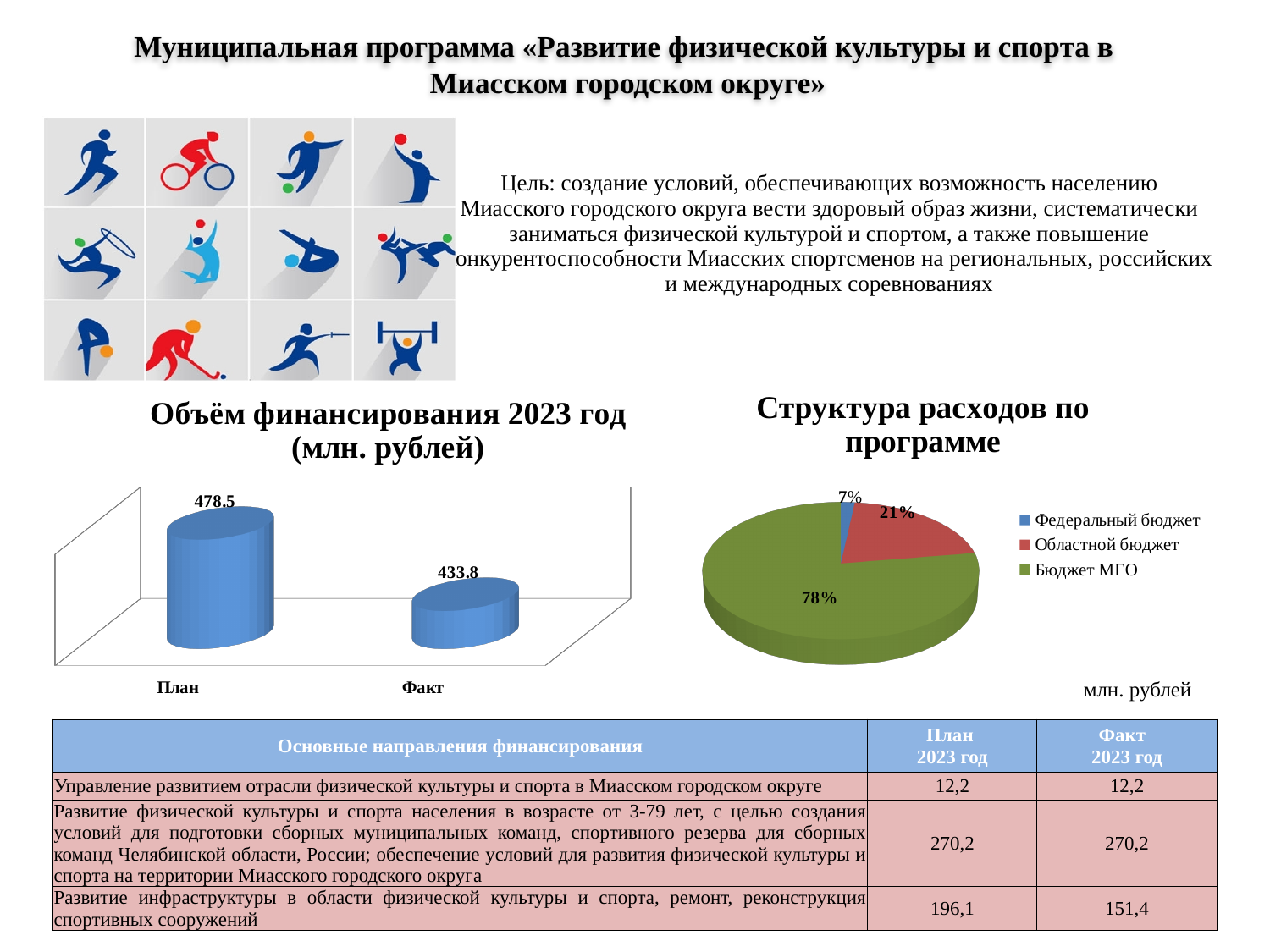
In the chart 'Объём финансирования 2023 год (млн. рублей)', how many categories are shown? 2 In the pie chart 'Структура расходов по программе', what share does Бюджет МГО have? 78% What kind of chart is 'Объём финансирования 2023 год (млн. рублей)'? Bar chart What kind of chart is 'Структура расходов по программе'? Pie chart In the pie chart 'Структура расходов по программе', what share does Федеральный бюджет have? 7% In the chart 'Объём финансирования 2023 год (млн. рублей)', what is the value for План? 478.5 In the chart 'Объём финансирования 2023 год (млн. рублей)', what is the difference between План and Факт? 44.7 In the pie chart 'Структура расходов по программе', which slice is the smallest? Федеральный бюджет In the chart 'Объём финансирования 2023 год (млн. рублей)', which category has the higher value? План In the chart 'Объём финансирования 2023 год (млн. рублей)', what is the value for Факт? 433.8 In the pie chart 'Структура расходов по программе', what share does Областной бюджет have? 21% In the pie chart 'Структура расходов по программе', how many entries does the legend list? 3